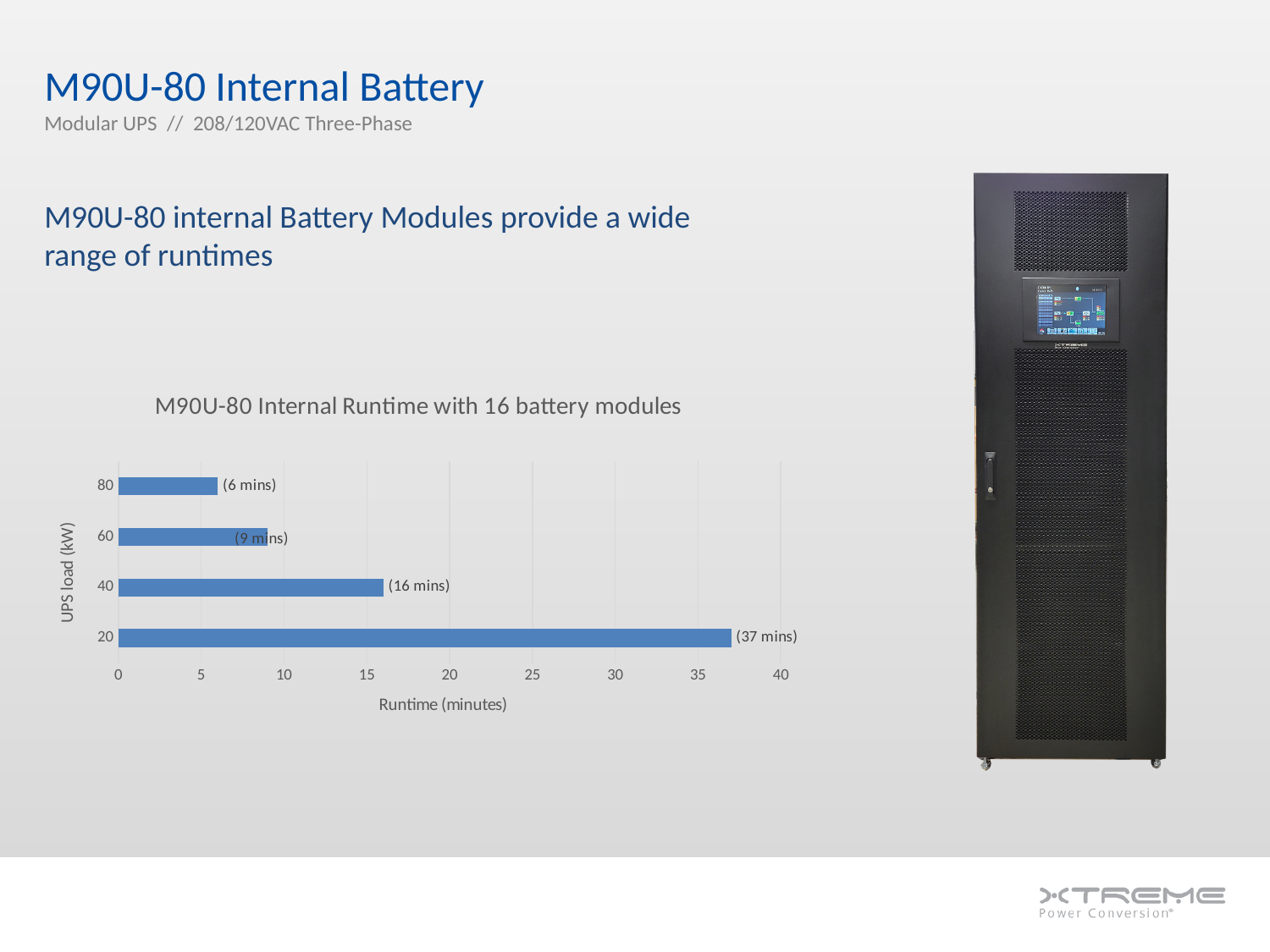
Which has a longer runtime, the 40 kW load or the 60 kW load? 40 kW How many UPS load categories are shown in the chart? 4 What is the difference in runtime between the 20 kW load and the 40 kW load? 21 mins Which UPS load has the shortest runtime? 80 What type of chart is shown on the slide? Bar chart What is the runtime for a UPS load of 60 kW? 9 mins What is the runtime for a UPS load of 40 kW? 16 mins What is the runtime for a UPS load of 20 kW? 37 mins What is the runtime for a UPS load of 80 kW? 6 mins Which UPS load has the longest runtime? 20 Is the runtime for the 20 kW load greater or less than 35 minutes? greater What is the title of the chart? M90U-80 Internal Runtime with 16 battery modules